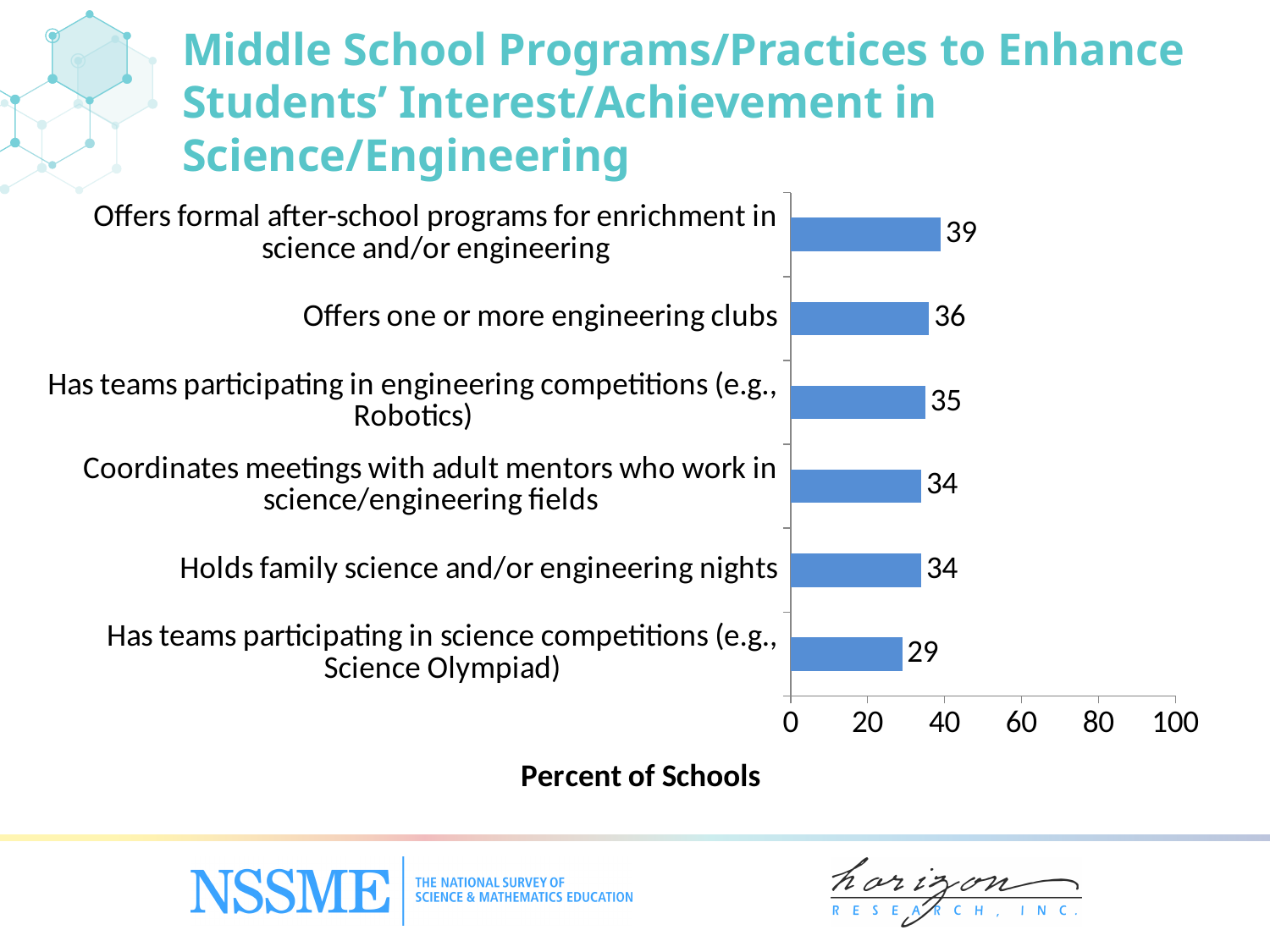
Which program/practice has the highest percent of schools? Offers formal after-school programs for enrichment in science and/or engineering What percent of schools offer formal after-school programs for enrichment in science and/or engineering? 39 What percent of schools offer one or more engineering clubs? 36 What is the difference in percent of schools between offering formal after-school programs and having teams in science competitions? 10 Is the value for coordinating meetings with adult mentors greater or less than 40? less What percent of schools hold family science and/or engineering nights? 34 How many programs/practices are shown in the chart? 6 What kind of chart is shown on the slide? Bar chart What percent of schools have teams participating in science competitions (e.g., Science Olympiad)? 29 Which is larger: the percent of schools offering one or more engineering clubs or the percent with teams participating in engineering competitions? Offers one or more engineering clubs What is the label of the horizontal axis? Percent of Schools Which program/practice has the lowest percent of schools? Has teams participating in science competitions (e.g., Science Olympiad)